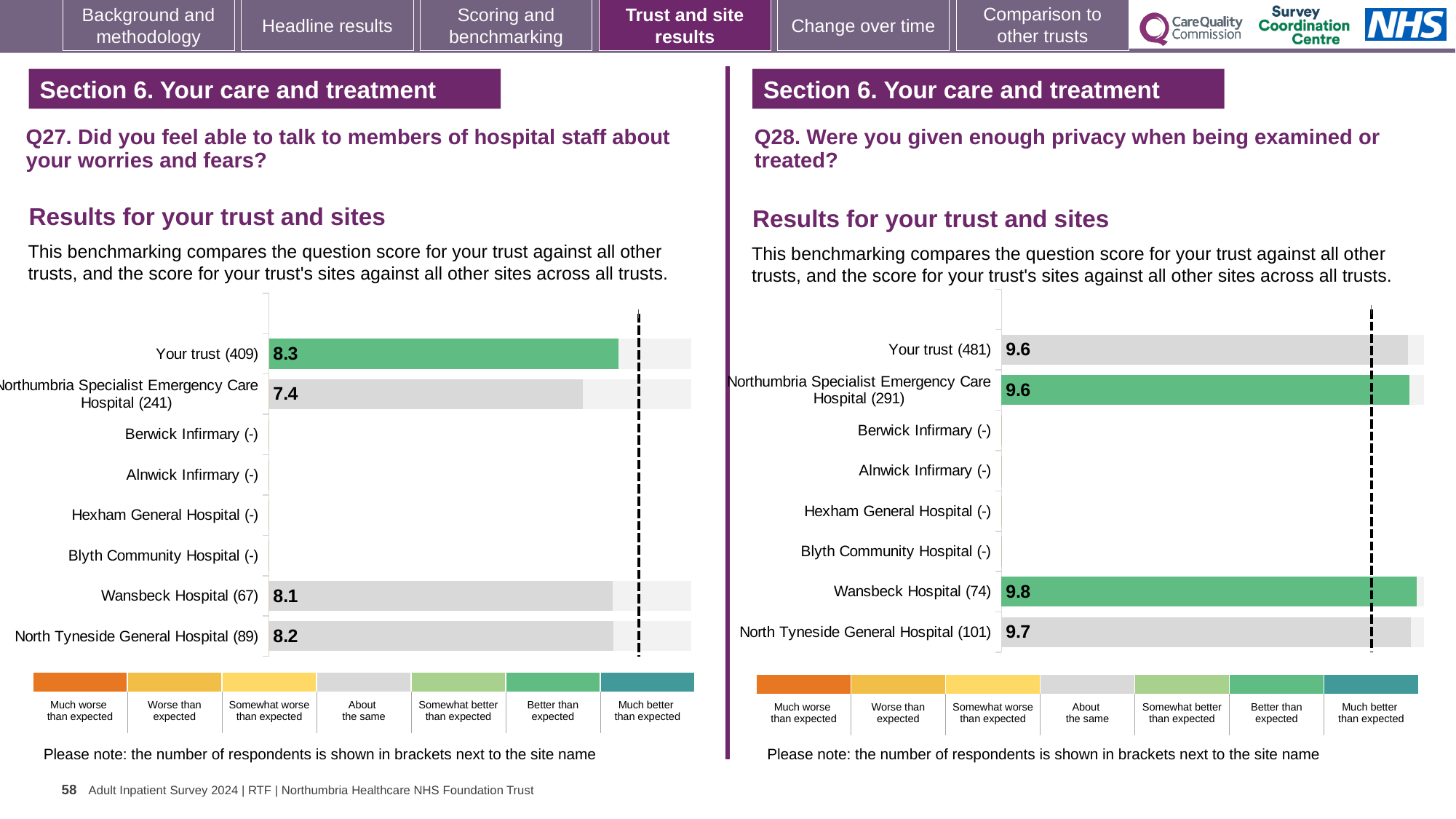
In the Q27 chart, what is the score for Northumbria Specialist Emergency Care Hospital (241)? 7.4 What type of chart is used for the Q27 results? Bar chart In the Q27 chart, which benchmark category does the green colour of the Your trust (409) bar represent according to the legend? Better than expected In the Q28 chart, what is the score for Wansbeck Hospital (74)? 9.8 In the Q27 chart, what is the score for Your trust (409)? 8.3 In the Q27 chart, what is the difference between the score for Your trust (409) and the score for Northumbria Specialist Emergency Care Hospital (241)? 0.9 In the Q27 chart, which has the higher score: Wansbeck Hospital (67) or North Tyneside General Hospital (89)? North Tyneside General Hospital (89) How many site or trust rows are listed on the Q28 chart's axis? 8 In the Q28 chart, what is the score for North Tyneside General Hospital (101)? 9.7 In the Q28 chart, what is the difference between the score for Wansbeck Hospital (74) and the score for Your trust (481)? 0.2 In the Q28 chart, which site or trust row has the highest score? Wansbeck Hospital (74) In the Q27 chart, which site or trust row has the lowest score? Northumbria Specialist Emergency Care Hospital (241)